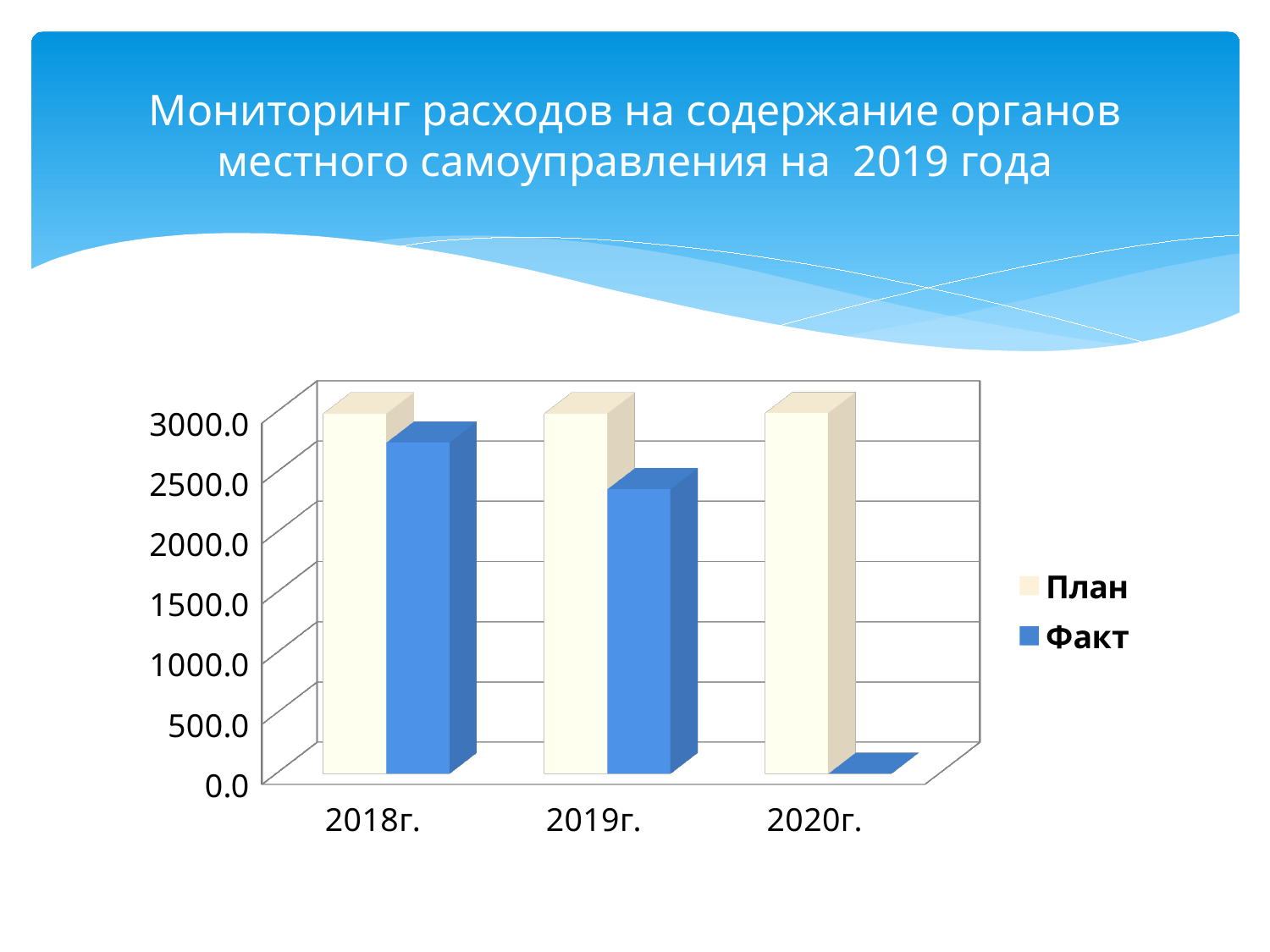
In 2019г., which series has the larger value, План or Факт? План Which year has the highest value for Факт? 2018г. Do the Факт values rise or fall from 2018г. to 2020г.? fall Is the Факт value for 2020г. greater or less than 500? less How many series does the legend list? 2 Is the Факт value for 2018г. greater or less than 2500? greater Which is larger, the Факт value for 2018г. or for 2019г.? 2018г. What are the two entries in the chart legend? План and Факт How many categories (years) are shown on the x axis? 3 Is the Факт value for 2019г. greater or less than 2000? greater What kind of chart is shown on the slide? bar chart Which year has the lowest value for Факт? 2020г.